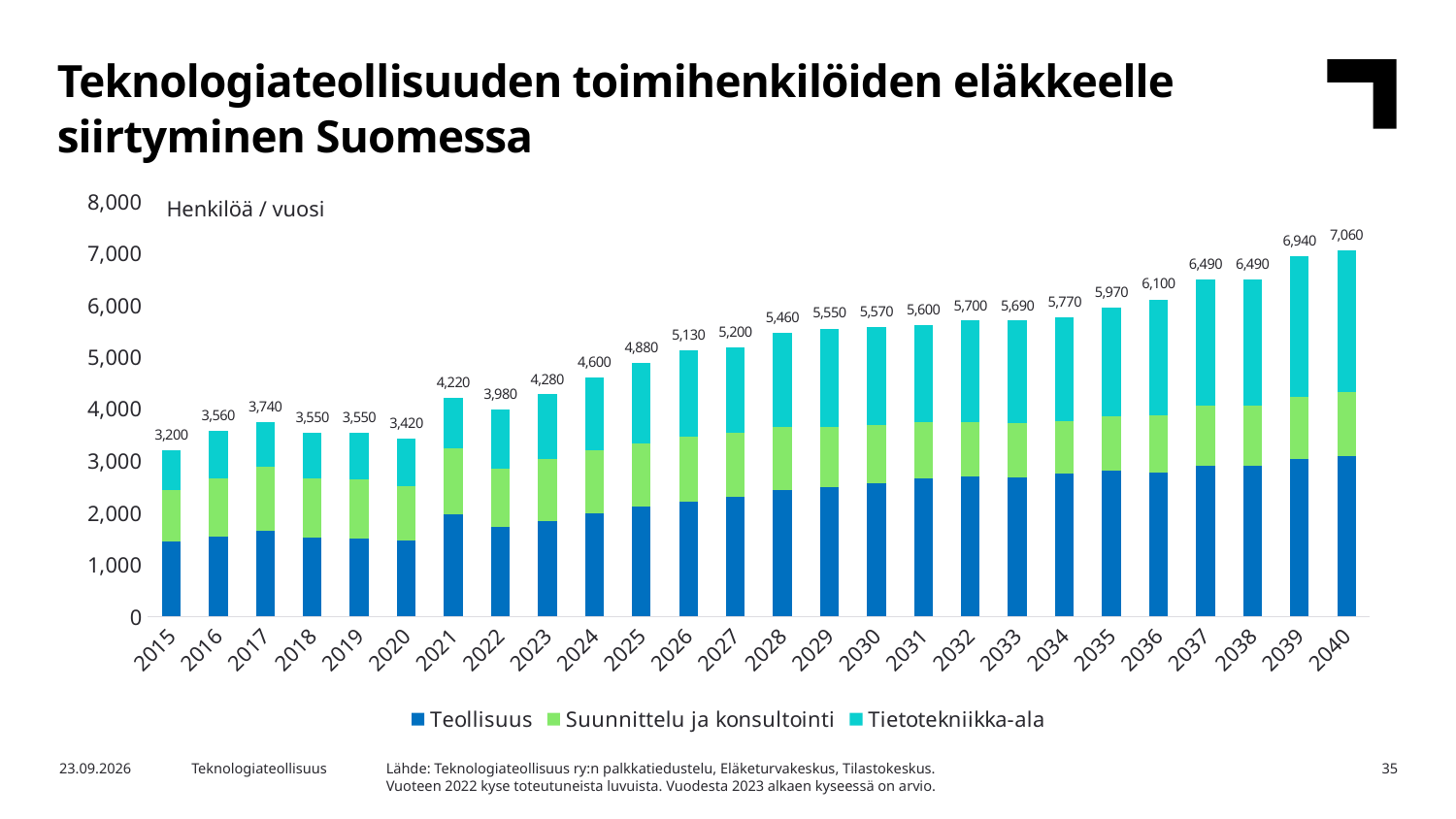
Which year has the lowest total? 2015 How many series does the legend list? 3 How many years are shown on the x axis? 26 Which year has the highest total? 2040 What is the difference between the totals for 2040 and 2015? 3,860 Is the Teollisuus value for 2015 greater or less than 2,000? less What is the total value shown for 2015? 3,200 What kind of chart is shown? stacked bar chart Which total is larger, 2021 or 2022? 2021 What is the total value shown for 2040? 7,060 What is the total value shown for 2028? 5,460 What unit label is shown at the top of the chart? Henkilöä / vuosi